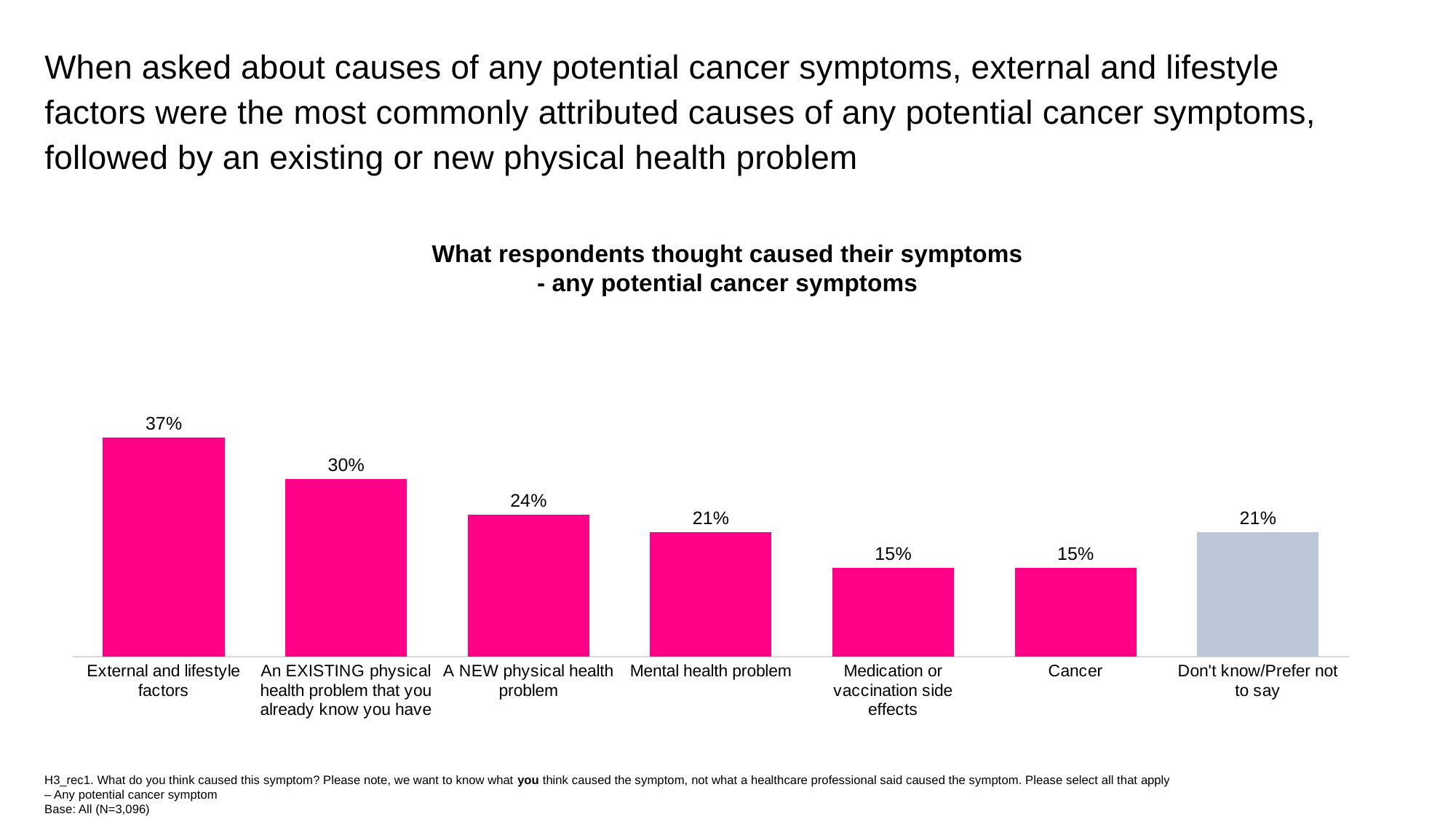
What is the difference between the values for 'Mental health problem' and 'Cancer'? 6% What is the title of the chart? What respondents thought caused their symptoms - any potential cancer symptoms What is the value for 'A NEW physical health problem'? 24% What is the difference between the values for 'External and lifestyle factors' and 'An EXISTING physical health problem that you already know you have'? 7% Which bar is coloured differently (grey) from the others? Don't know/Prefer not to say Which is larger: the value for 'A NEW physical health problem' or the value for 'Mental health problem'? A NEW physical health problem Which category has the highest value? External and lifestyle factors What percentage of respondents attributed their symptoms to external and lifestyle factors? 37% What is the value for 'Don't know/Prefer not to say'? 21% How many categories are shown in the chart? 7 What kind of chart is shown on the slide? Bar chart What percentage of respondents thought cancer caused their symptoms? 15%